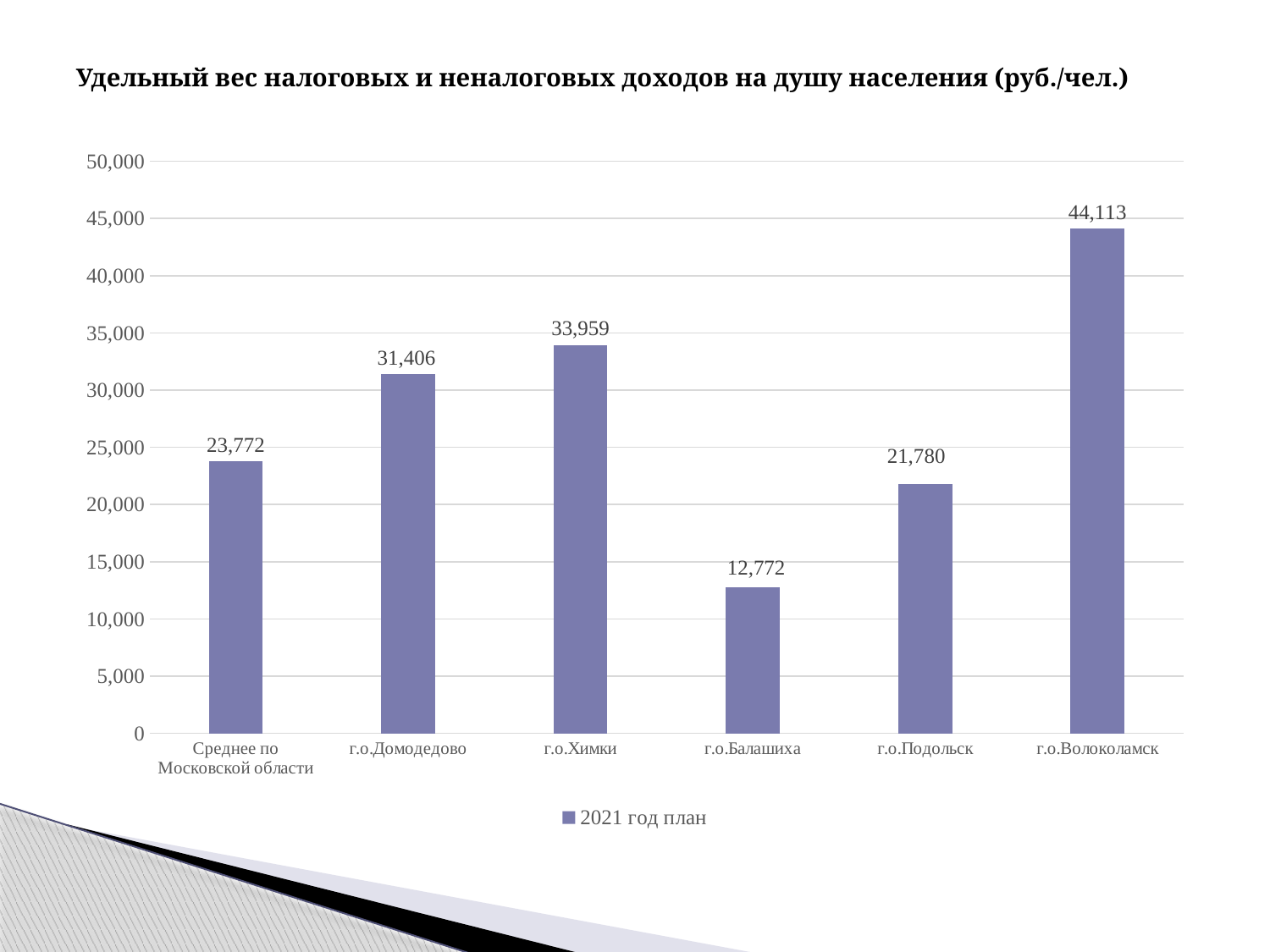
Which category has the lowest value? г.о.Балашиха What is the value for г.о.Балашиха? 12,772 What is the value for Среднее по Московской области? 23,772 What kind of chart is shown on the slide? bar chart Is the value for г.о.Подольск greater or less than 25,000? less Which is larger, the value for г.о.Химки or the value for г.о.Домодедово? г.о.Химки Which category has the highest value? г.о.Волоколамск How many categories are shown on the x axis? 6 What is the difference between the values for г.о.Домодедово and г.о.Подольск? 9,626 How many series does the legend list? 1 What is the value for г.о.Домодедово? 31,406 What is the difference between the values for г.о.Волоколамск and г.о.Химки? 10,154